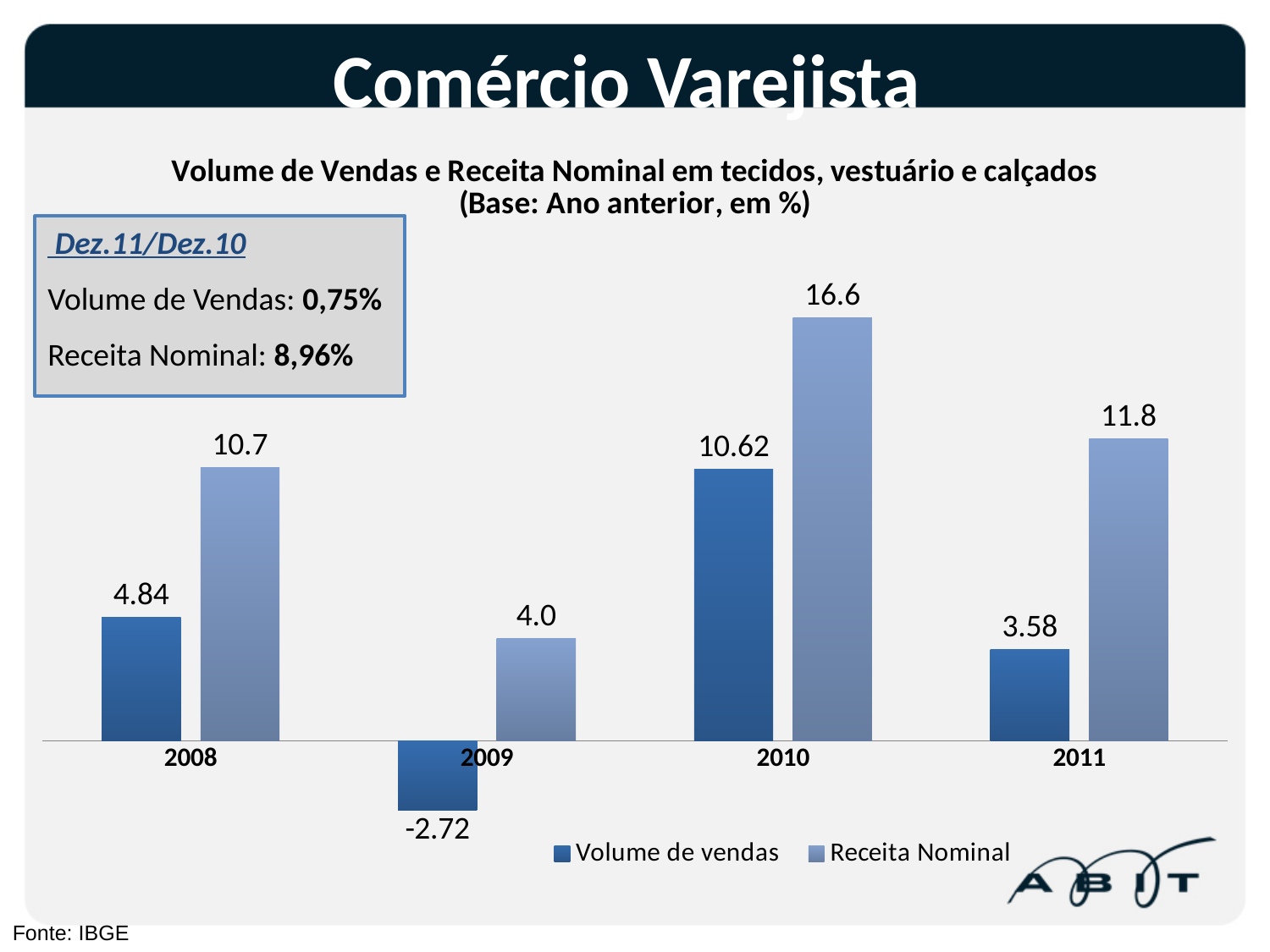
What are the two series listed in the legend? Volume de vendas and Receita Nominal What is the Volume de vendas value for 2009? -2.72 Which is larger, the Volume de vendas value for 2008 or for 2011? 2008 What is the Volume de vendas value for 2010? 10.62 What kind of chart is shown on the slide? Bar chart How many years are shown on the x axis? 4 What is the Receita Nominal value for 2011? 11.8 Which year has the lowest Volume de vendas value? 2009 What is the difference between the Receita Nominal values for 2010 and 2011? 4.8 What is the Receita Nominal value for 2009? 4.0 How many series does the legend list? 2 Which year has the highest Receita Nominal value? 2010